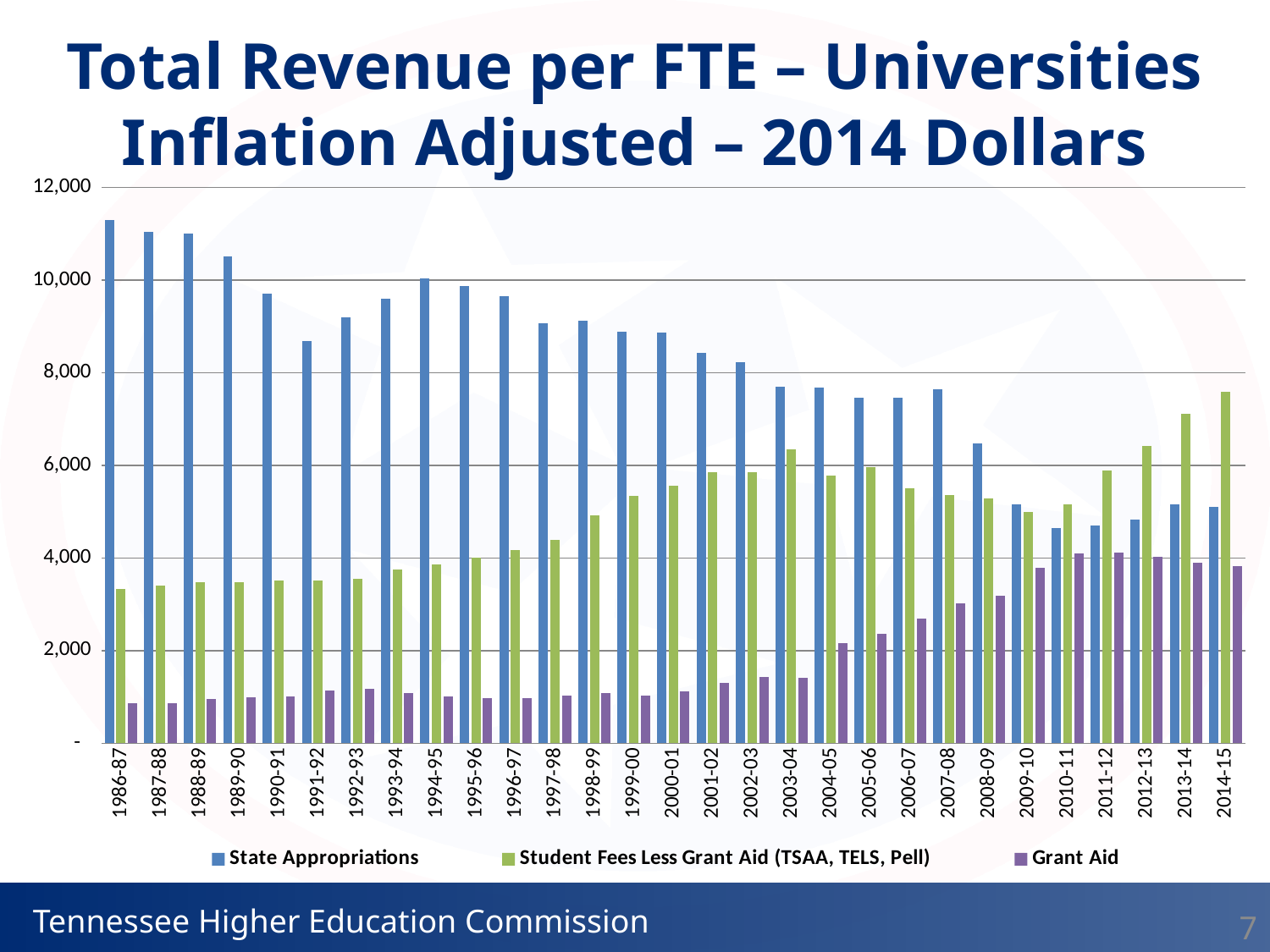
How many academic years are shown on the x axis? 29 In 2014-15, which is larger: State Appropriations or Student Fees Less Grant Aid? Student Fees Less Grant Aid Is the value for State Appropriations in 1986-87 greater or less than 10,000? greater Is the value for Student Fees Less Grant Aid in 2014-15 greater or less than 6,000? greater In 1986-87, which is larger: State Appropriations or Grant Aid? State Appropriations Does State Appropriations generally rise or fall from 1986-87 to 2014-15? Fall In which year is Student Fees Less Grant Aid (TSAA, TELS, Pell) highest? 2014-15 What kind of chart is shown on the slide? Bar chart How many series does the legend list? 3 Is the value for Grant Aid in 1986-87 greater or less than 2,000? less What is the title of the chart? Total Revenue per FTE – Universities Inflation Adjusted – 2014 Dollars In which year is State Appropriations highest? 1986-87